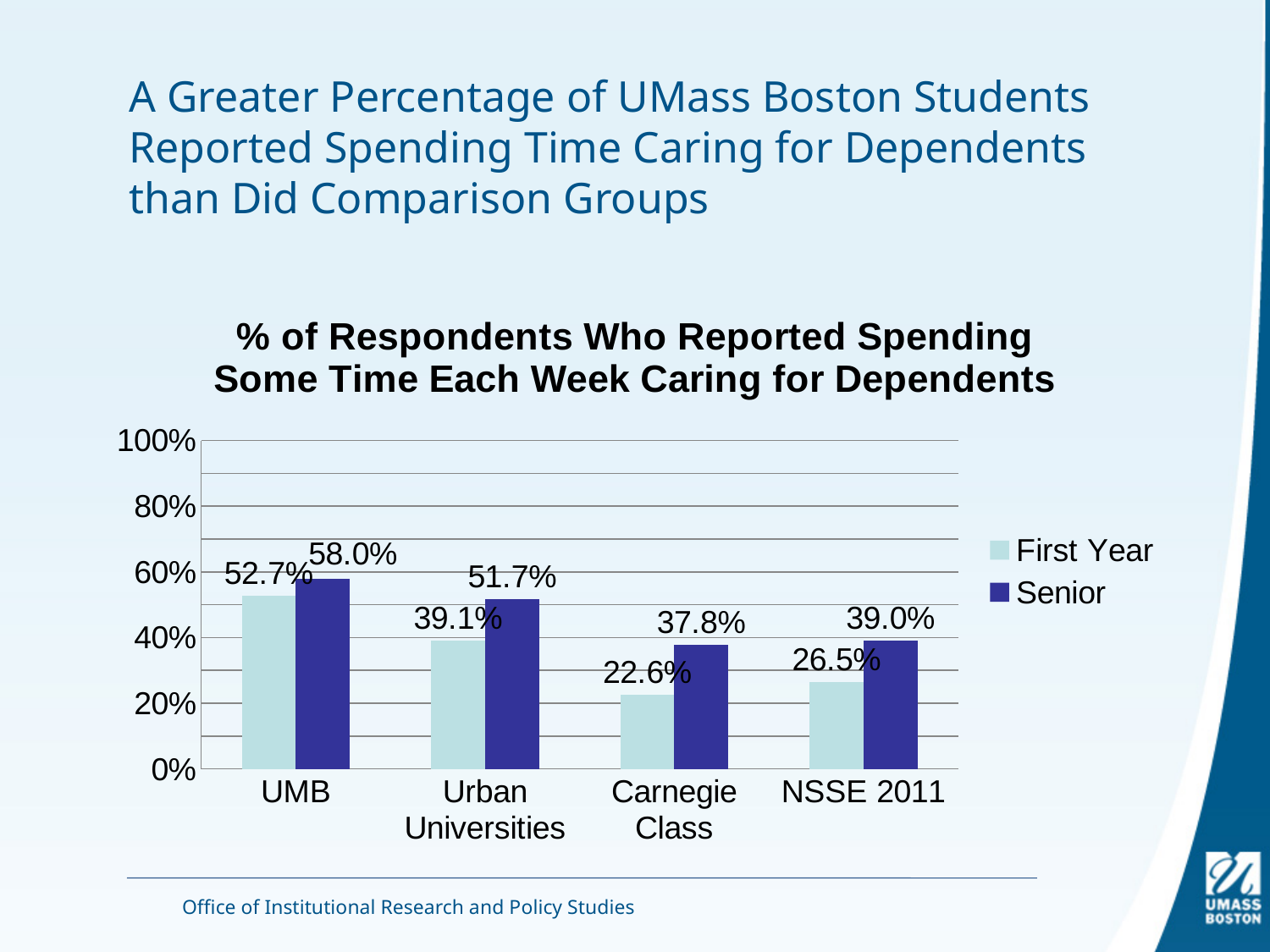
How many categories are shown on the x axis? 4 What are the two series named in the legend? First Year and Senior Which category has the highest Senior value? UMB Which category has the lowest First Year value? Carnegie Class How many series does the legend list? 2 What is the Senior value for NSSE 2011? 39.0% What kind of chart is shown on the slide? Bar chart What is the Senior value for Urban Universities? 51.7% What is the First Year value for Carnegie Class? 22.6% What is the difference between the Senior and First Year values for UMB? 5.3% Which is larger: the First Year value for Urban Universities or the First Year value for NSSE 2011? Urban Universities What percentage of First Year respondents at UMB reported spending some time each week caring for dependents? 52.7%